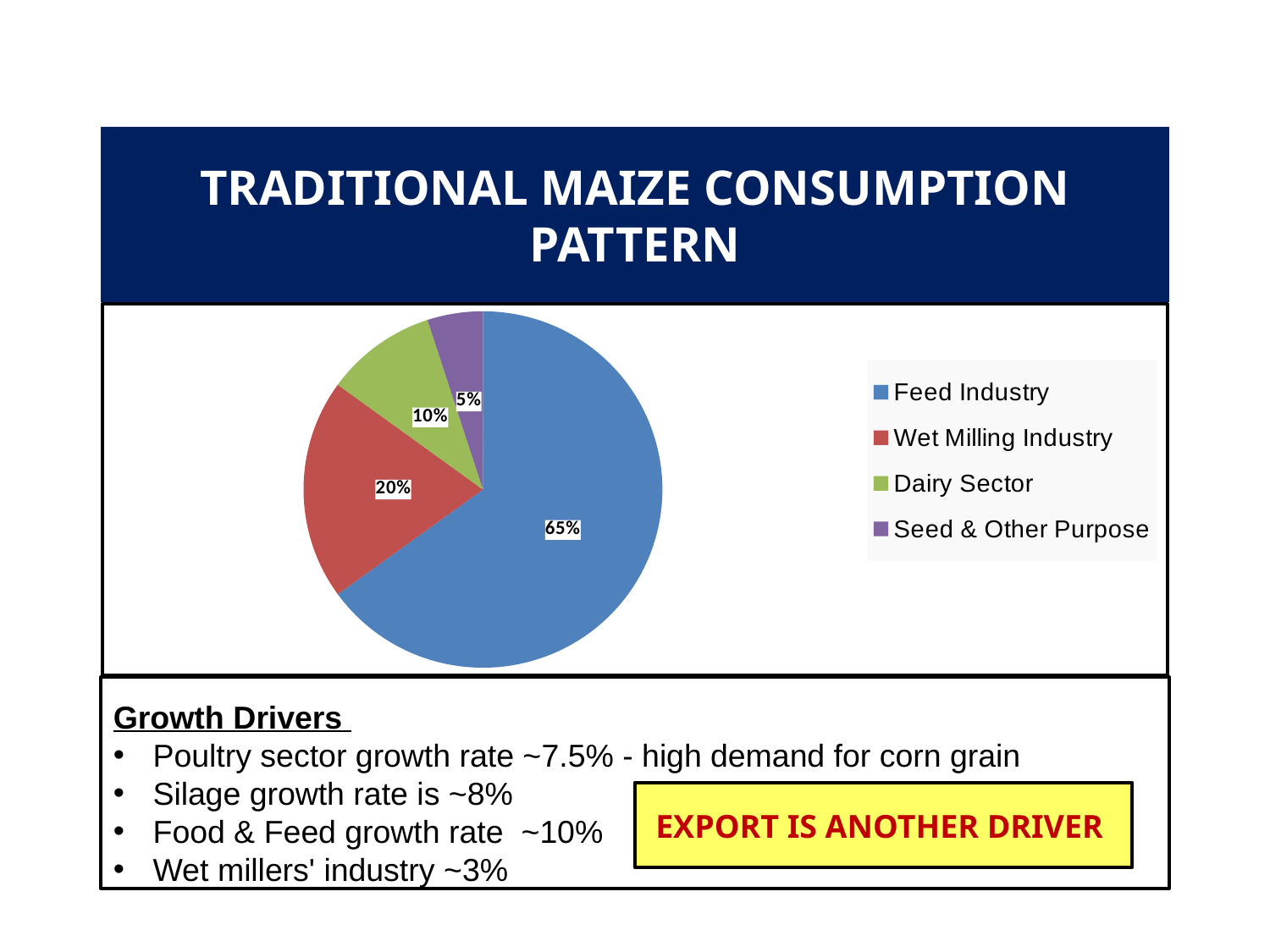
How many slices does the pie chart have? 4 What is the title of the slide containing the chart? TRADITIONAL MAIZE CONSUMPTION PATTERN Which category has the largest share of the pie? Feed Industry What percentage of the pie is the Wet Milling Industry? 20% What share of traditional maize consumption goes to the Feed Industry? 65% Which category has the smallest share of the pie? Seed & Other Purpose What type of chart is shown on the slide? Pie chart What colour is the Dairy Sector slice in the pie chart? Green Which is larger, the Dairy Sector share or the Wet Milling Industry share? Wet Milling Industry What percentage is labelled for Seed & Other Purpose? 5% What share does the Dairy Sector account for? 10% How many percentage points larger is the Feed Industry share than the Wet Milling Industry share? 45